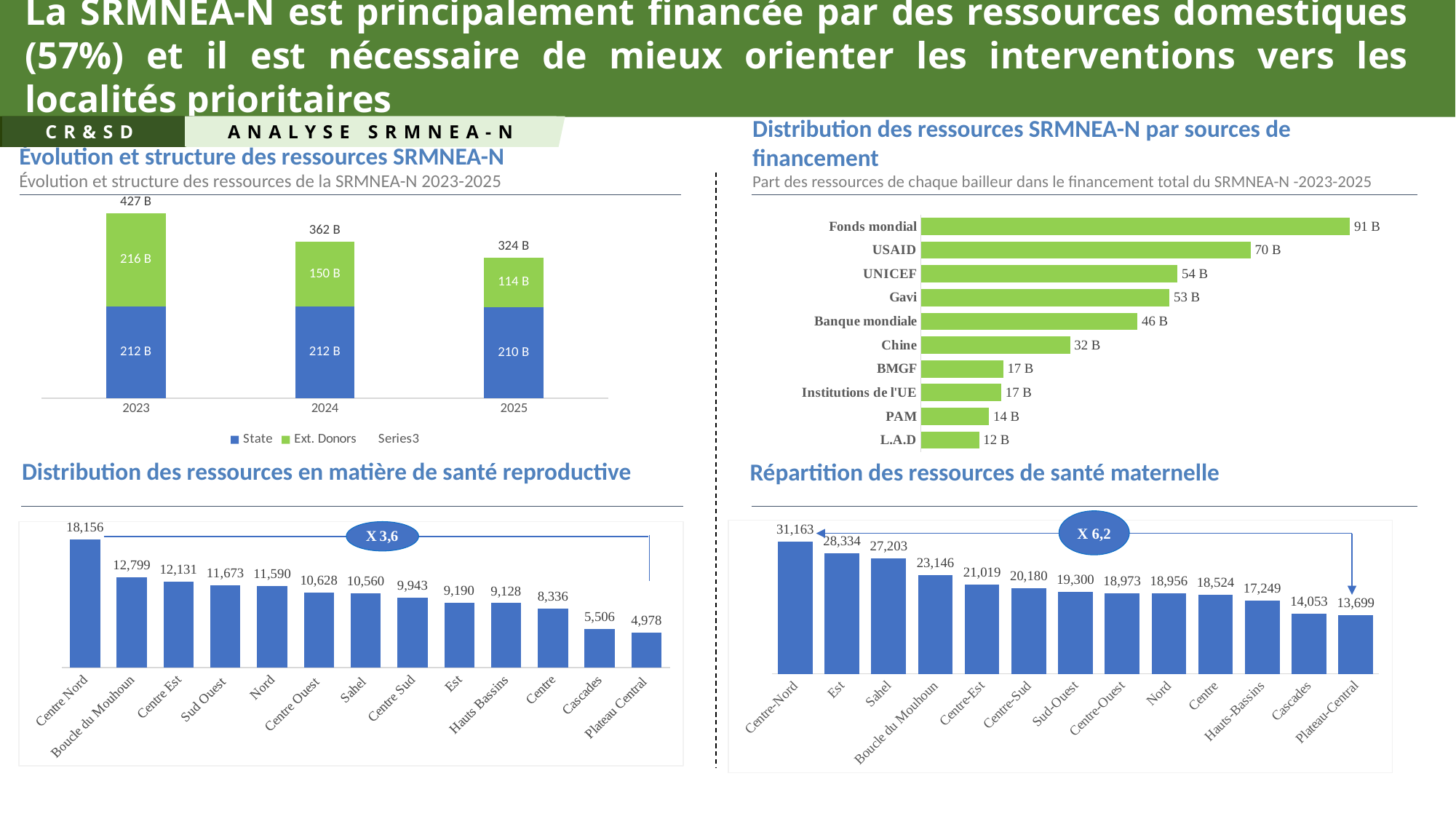
In the chart 'Évolution et structure des ressources SRMNEA-N', do the Ext. Donors values rise or fall from 2023 to 2025? fall What kind of chart is 'Distribution des ressources SRMNEA-N par sources de financement'? bar chart In the chart 'Répartition des ressources de santé maternelle', which is larger, Est or Sahel? Est In the chart 'Distribution des ressources SRMNEA-N par sources de financement', which source has the highest value? Fonds mondial In the chart 'Évolution et structure des ressources SRMNEA-N', what is the total of the stacked bar for 2025? 324 B In the chart 'Répartition des ressources de santé maternelle', what is the difference between Centre-Nord and Plateau-Central? 17,464 In the chart 'Distribution des ressources en matière de santé reproductive', which region has the lowest value? Plateau Central In the chart 'Distribution des ressources en matière de santé reproductive', what is the value for Sahel? 10,560 How many sources are shown in the chart 'Distribution des ressources SRMNEA-N par sources de financement'? 10 In the chart 'Distribution des ressources SRMNEA-N par sources de financement', what is the difference between Fonds mondial and USAID? 21 B In the chart 'Évolution et structure des ressources SRMNEA-N', what is the State value for 2024? 212 B How many series does the legend of the chart 'Évolution et structure des ressources SRMNEA-N' list? 3